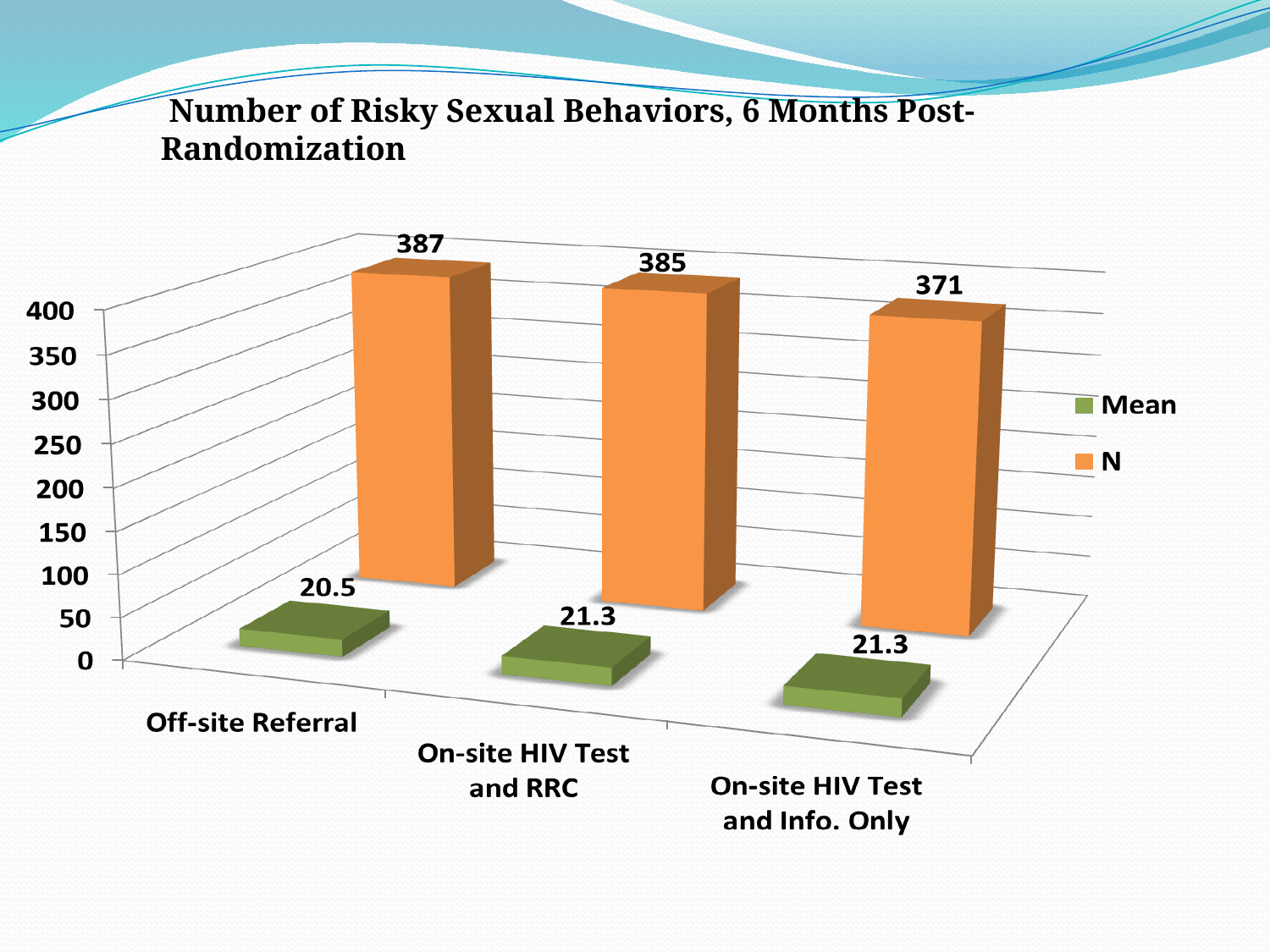
Which is larger, the N value for On-site HIV Test and RRC or the N value for On-site HIV Test and Info. Only? On-site HIV Test and RRC What is the Mean value for On-site HIV Test and RRC? 21.3 What kind of chart is shown on the slide? Bar chart What is the difference between the N values for Off-site Referral and On-site HIV Test and Info. Only? 16 How many categories are shown on the x axis? 3 What is the Mean value for Off-site Referral? 20.5 What is the title of the chart? Number of Risky Sexual Behaviors, 6 Months Post-Randomization What is the N value for Off-site Referral? 387 Which category has the lowest N value? On-site HIV Test and Info. Only What is the N value for On-site HIV Test and Info. Only? 371 How many series does the legend list? 2 Which category has the highest N value? Off-site Referral